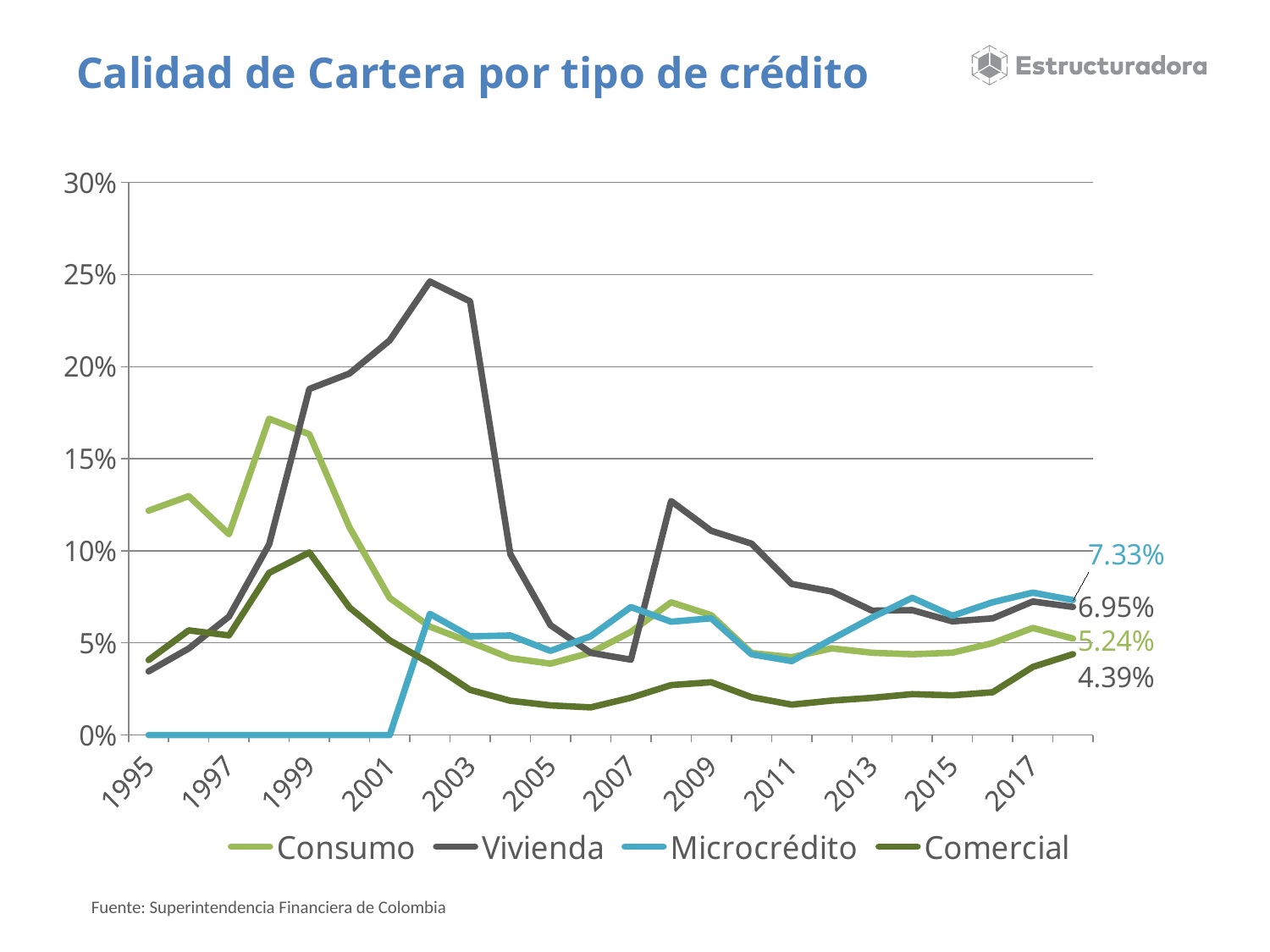
What is the difference between the final labelled values of Microcrédito and Comercial? 2.94% Which series has the lowest value at the end of the chart? Comercial What is the final labelled value for Consumo? 5.24% What is the title of the chart? Calidad de Cartera por tipo de crédito Does the Vivienda line rise or fall between 2002 and 2005? fall Which series has the highest value at the end of the chart? Microcrédito What is the final labelled value for Microcrédito? 7.33% How many series does the legend list? 4 What is the final labelled value for Comercial? 4.39% What is the final labelled value for Vivienda? 6.95% Is the peak value of Vivienda around 2002 greater or less than 20%? greater What kind of chart is shown on the slide? line chart